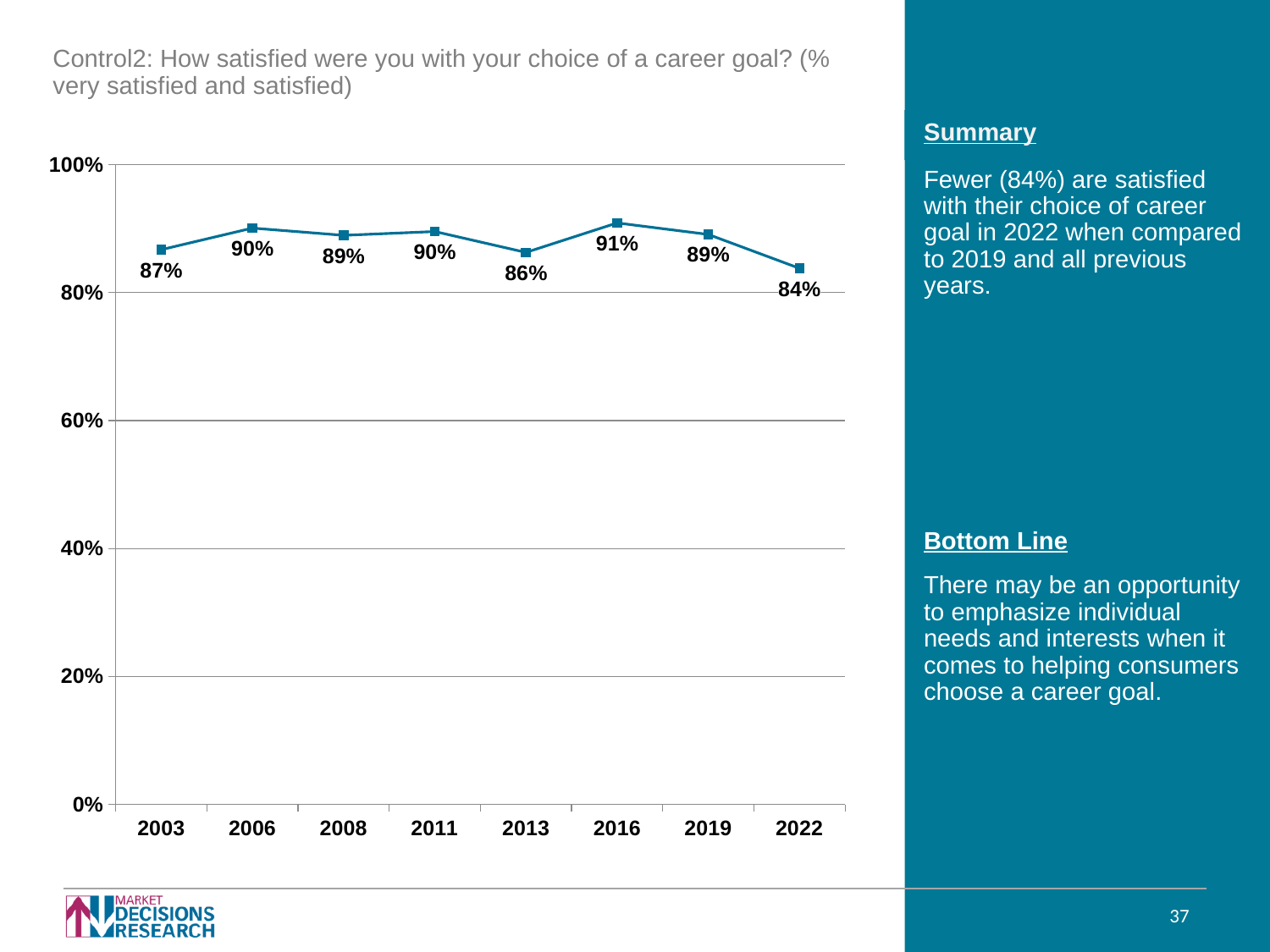
Which year had the lowest percentage satisfied with their choice of career goal? 2022 Which year had the highest percentage satisfied with their choice of career goal? 2016 What kind of chart is shown on the slide? Line chart What was the percentage satisfied with their choice of career goal in 2013? 86% Which year had a higher percentage satisfied, 2006 or 2013? 2006 How many years are plotted on the chart? 8 What is the difference in percentage points between 2016 and 2013? 5 What was the percentage satisfied with their choice of career goal in 2022? 84% What is the difference in percentage points between 2019 and 2022? 5 Is the value for 2022 greater or less than 80%? greater What was the percentage satisfied with their choice of career goal in 2003? 87% Did the percentage satisfied rise or fall from 2019 to 2022? Fall